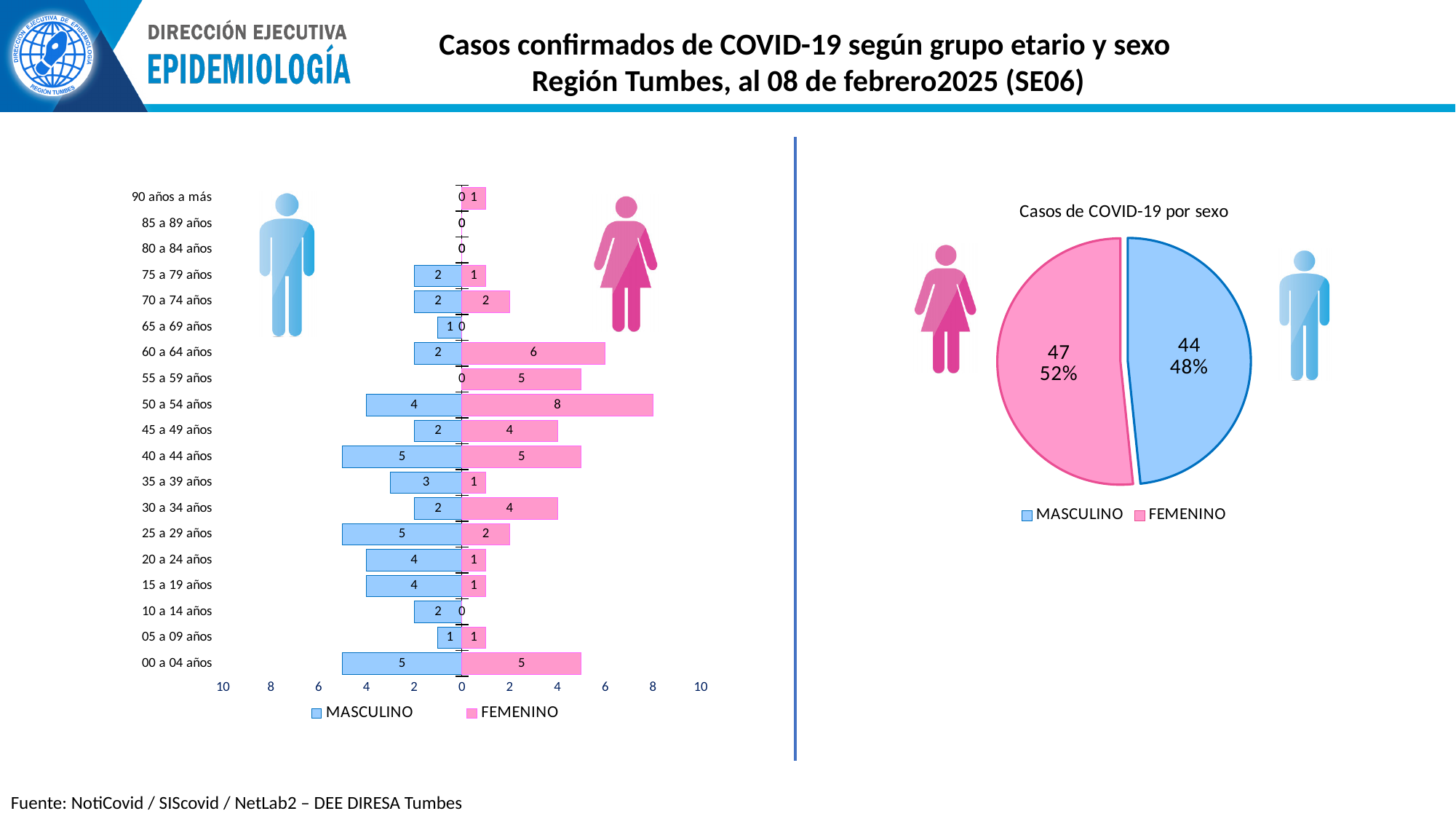
In the left bar chart by age group, how many FEMENINO cases are in the '50 a 54 años' group? 8 What type of chart is the left chart showing cases by age group and sex? Bar chart In the left bar chart by age group, how many MASCULINO cases are in the '25 a 29 años' group? 5 In the pie chart 'Casos de COVID-19 por sexo', what share of cases is FEMENINO? 52% In the left bar chart by age group, how many age groups are shown on the vertical axis? 19 In the left bar chart by age group, which colour represents the FEMENINO series? Pink In the left bar chart by age group, what is the total number of cases (MASCULINO plus FEMENINO) in the '60 a 64 años' group? 8 In the left bar chart by age group, how many series does the legend list? 2 In the left bar chart by age group, which age group has the highest number of FEMENINO cases? 50 a 54 años In the pie chart 'Casos de COVID-19 por sexo', which sex has the larger slice? FEMENINO In the pie chart 'Casos de COVID-19 por sexo', what is the difference between the FEMENINO and MASCULINO case counts? 3 In the pie chart 'Casos de COVID-19 por sexo', how many cases are MASCULINO? 44